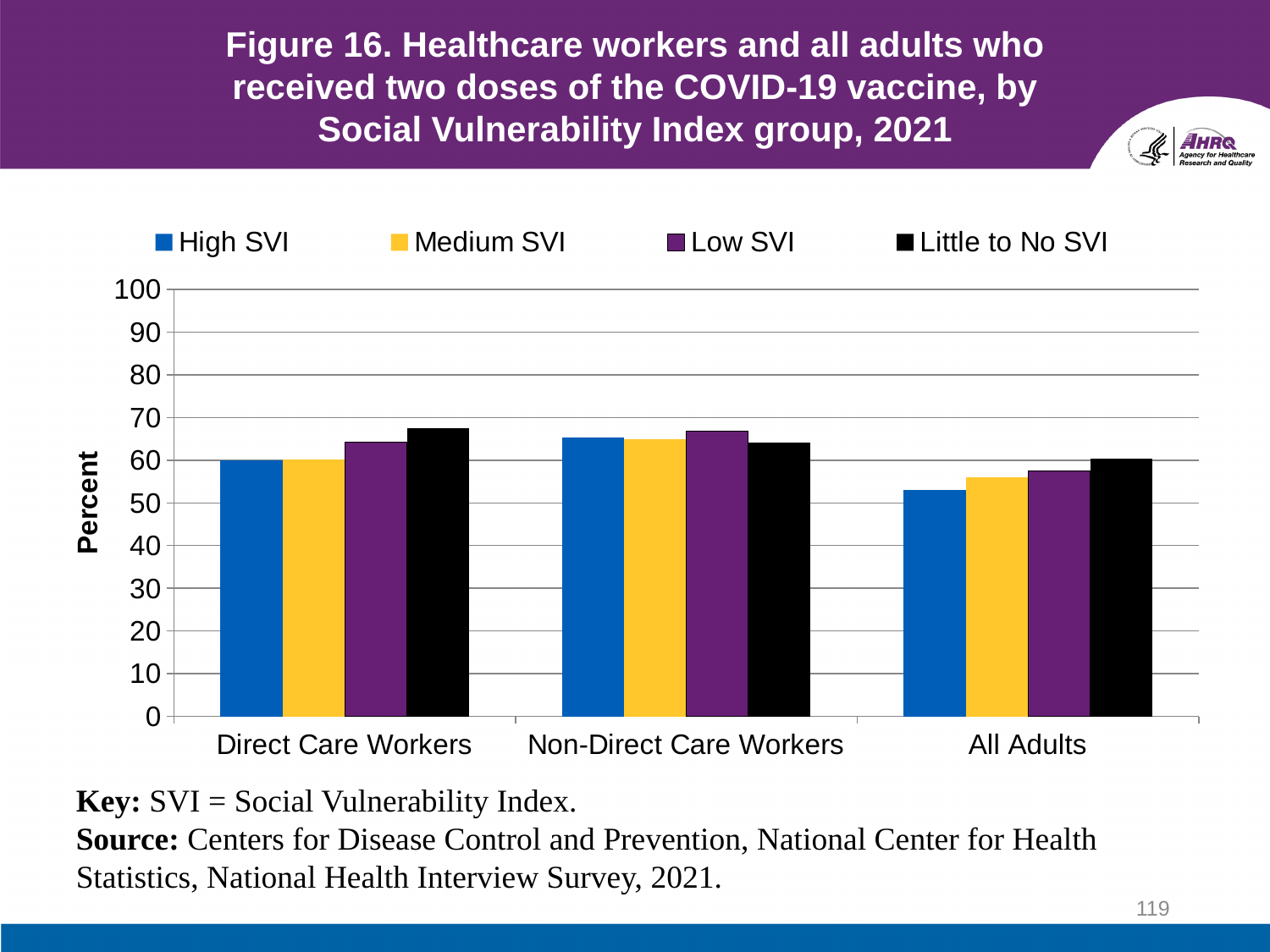
Among All Adults, which SVI group has the lowest value? High SVI Among Direct Care Workers, which SVI group has the highest value? Little to No SVI How many categories are shown on the x axis? 3 Among All Adults, which is larger: the value for High SVI or the value for Little to No SVI? Little to No SVI What is the label on the y axis? Percent What kind of chart is shown on the slide? bar chart Which colour represents Low SVI in the legend? purple Is the value for Low SVI among Non-Direct Care Workers greater or less than 60? greater Is the value for High SVI among All Adults greater or less than 50? greater How many series does the legend list? 4 Is the value for Little to No SVI among Direct Care Workers greater or less than 60? greater